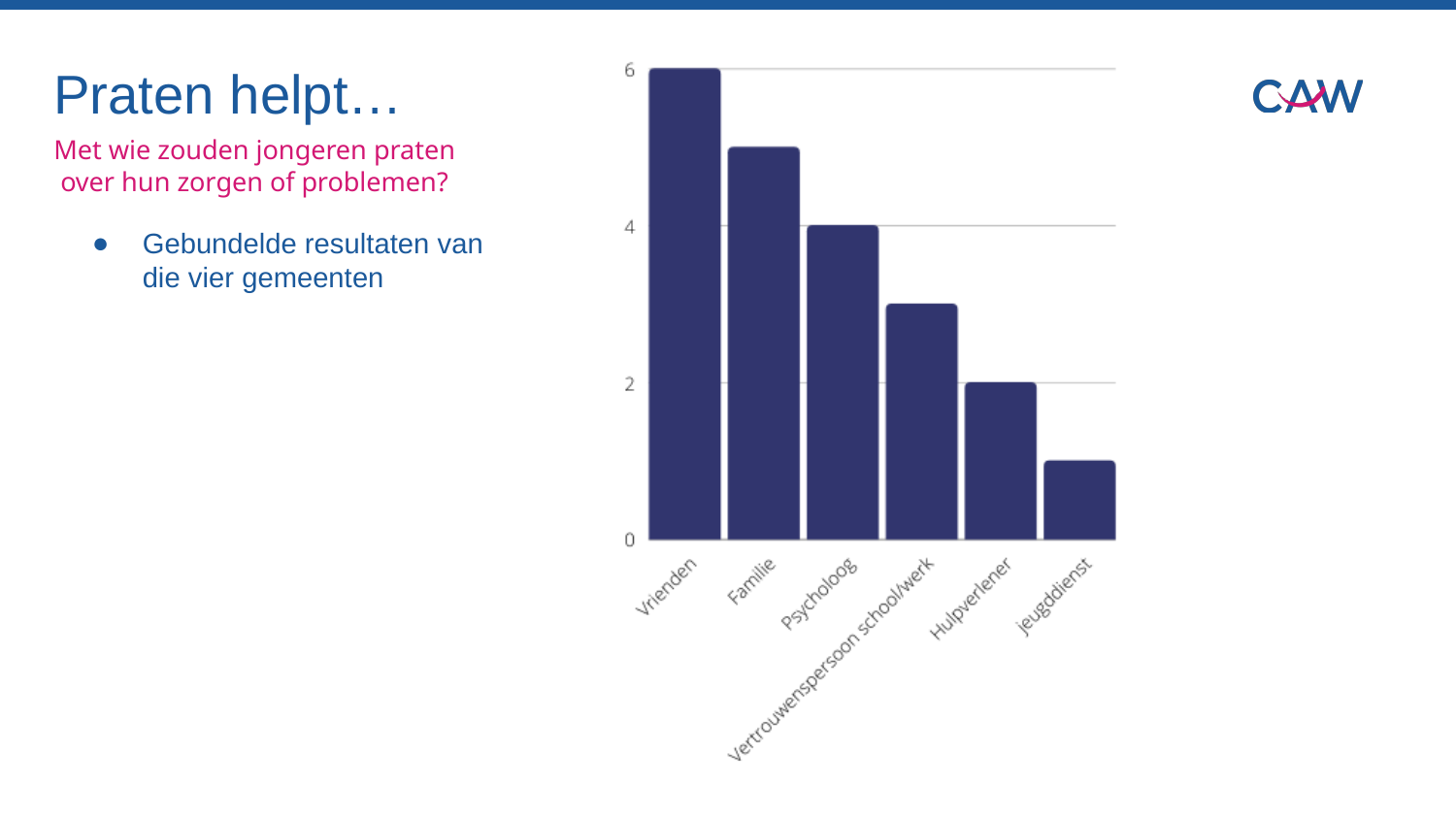
What is the value for Psycholoog? 4 Is the value for Jeugddienst greater or less than 2? less What is the value for Vrienden? 6 Which is larger, the value for Familie or the value for Vertrouwenspersoon school/werk? Familie Is the value for Familie greater or less than 4? greater How many categories are shown on the x axis of the chart? 6 Which category has the lowest bar in the chart? Jeugddienst What is the difference between the values for Vrienden and Psycholoog? 2 Which category has the highest bar in the chart? Vrienden What is the value for Hulpverlener? 2 What kind of chart is shown on the slide? bar chart Do the bar values rise or fall from left to right along the x axis? fall